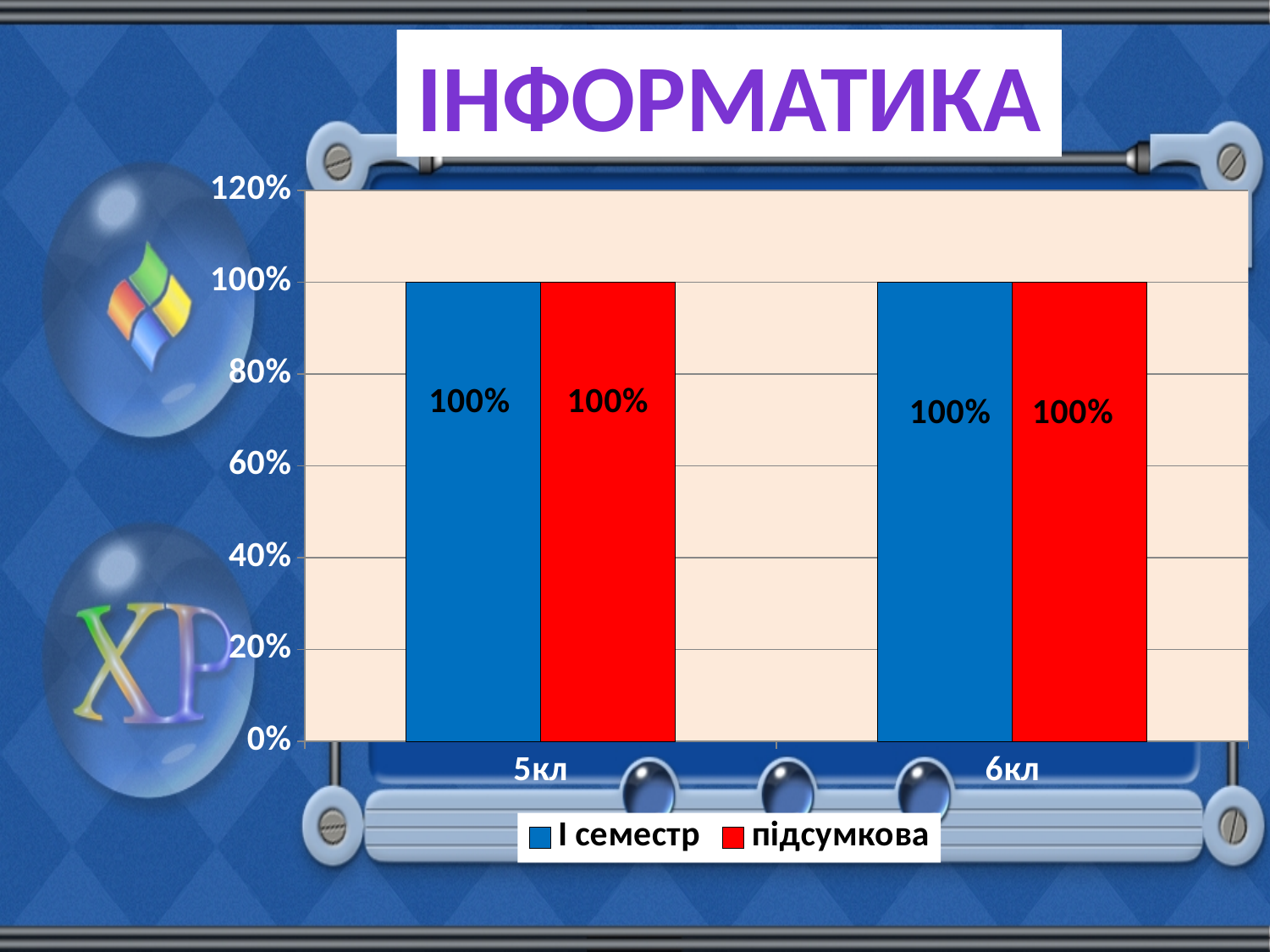
What is the value of підсумкова for 5кл? 100% What is the value of підсумкова for 6кл? 100% Which colour represents the підсумкова series? red What is the value of І семестр for 5кл? 100% What kind of chart is shown on the slide? bar chart What is the title of the chart? ІНФОРМАТИКА How many categories are shown on the x axis? 2 Do the І семестр values rise, fall or stay the same from 5кл to 6кл? stay the same How many series does the legend list? 2 What is the value of І семестр for 6кл? 100% What is the difference between the підсумкова values for 5кл and 6кл? 0% Is the value of І семестр for 6кл greater or less than 80%? greater